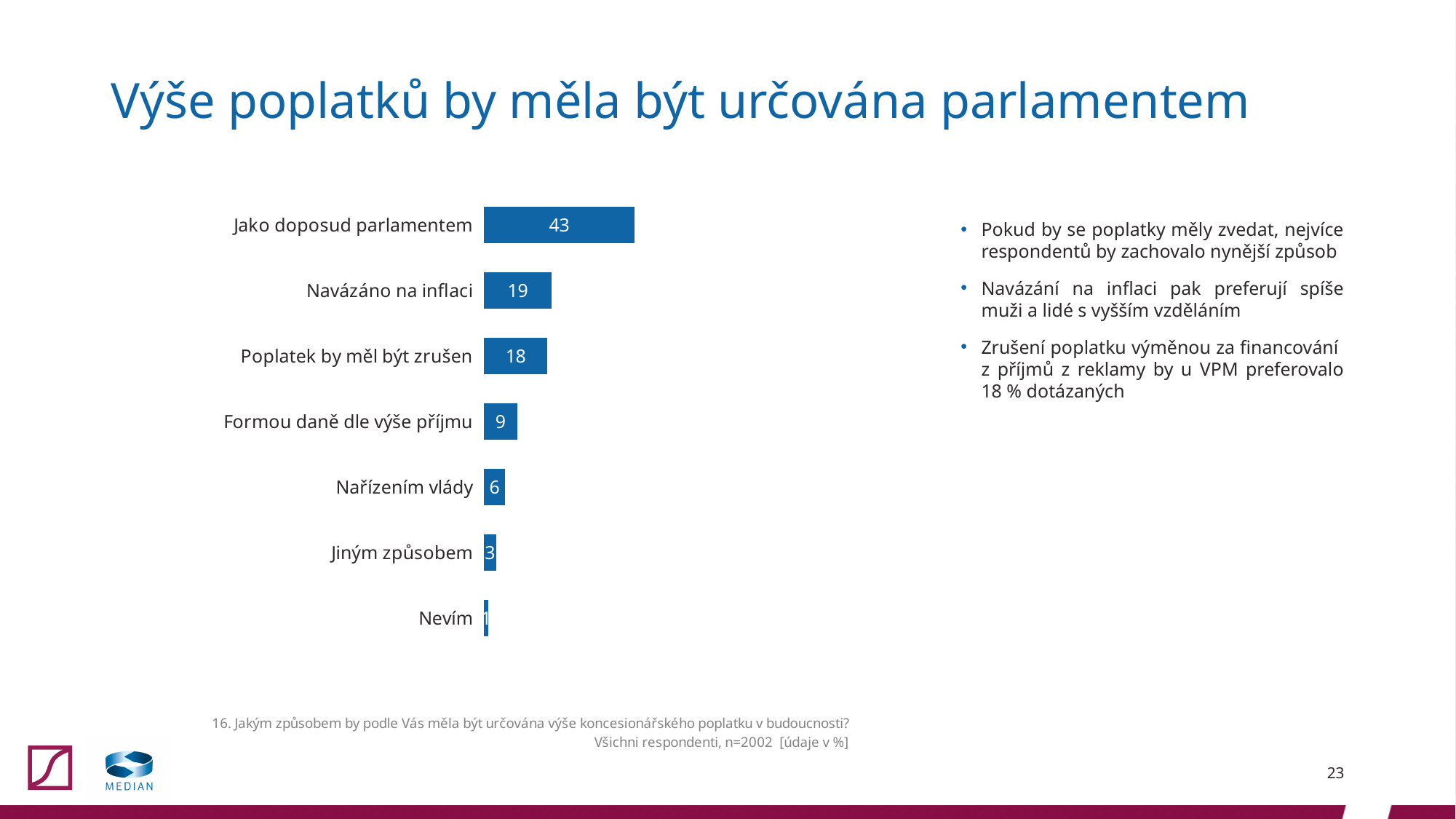
What is the value for "Navázáno na inflaci"? 19 What is the sample size (n) stated below the chart? n=2002 What is the difference between the values for "Poplatek by měl být zrušen" and "Formou daně dle výše příjmu"? 9 What is the value for "Formou daně dle výše příjmu"? 9 What is the value for "Nařízením vlády"? 6 What is the difference between the values for "Jako doposud parlamentem" and "Navázáno na inflaci"? 24 What is the value for "Jako doposud parlamentem"? 43 Which is larger, the value for "Nařízením vlády" or the value for "Jiným způsobem"? Nařízením vlády How many categories are shown in the chart? 7 Which category has the highest value? Jako doposud parlamentem What kind of chart is shown on the slide? Bar chart Which category has the lowest value? Nevím